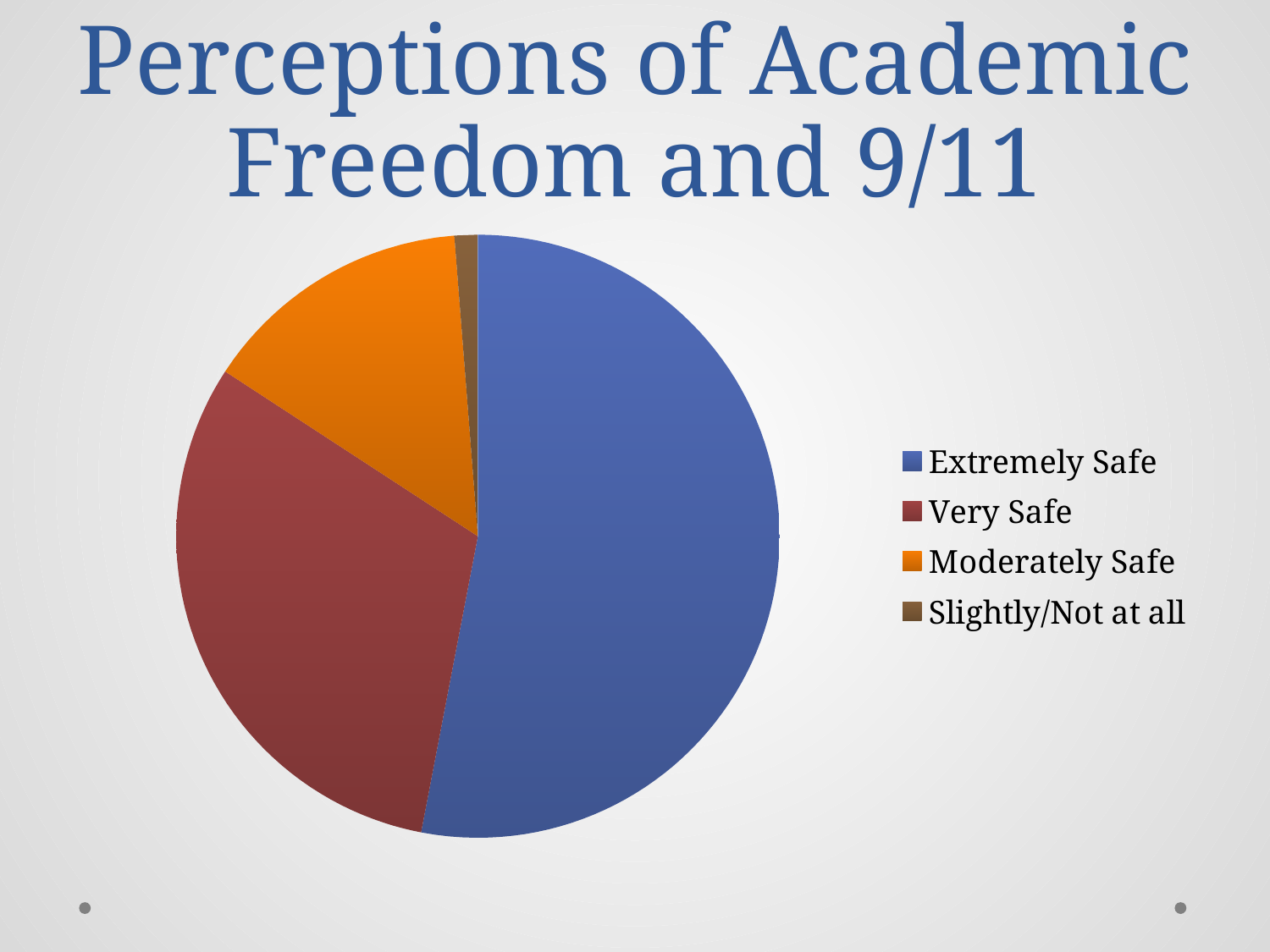
How many entries does the legend list? 4 Which category has the smallest slice of the pie? Slightly/Not at all How many slices does the pie chart have? 4 What kind of chart is shown on the slide? Pie chart What colour is the Moderately Safe slice in the pie chart? Orange Which slice is larger, Extremely Safe or Very Safe? Extremely Safe Which slice is larger, Moderately Safe or Slightly/Not at all? Moderately Safe What is the title of the slide containing the pie chart? Perceptions of Academic Freedom and 9/11 Which category has the largest slice of the pie? Extremely Safe Which slice is larger, Very Safe or Moderately Safe? Very Safe